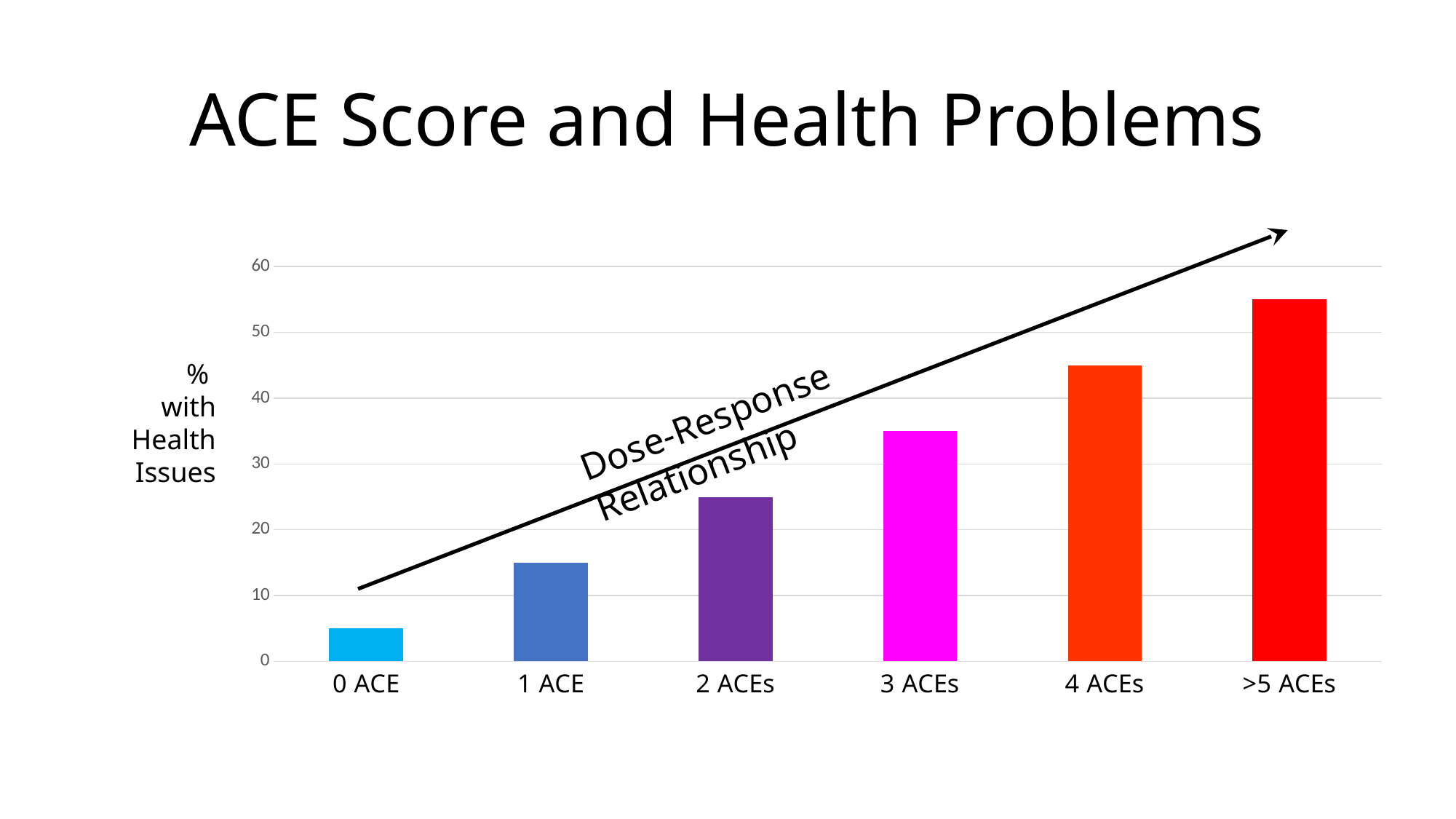
Is the value for 2 ACEs greater or less than 20? greater What relationship does the arrow annotation on the chart label? Dose-Response Relationship Is the value for 3 ACEs greater or less than 30? greater Which ACE score category has the highest percentage with health issues? >5 ACEs What type of chart is shown on the slide? bar chart Is the value for 1 ACE greater or less than 20? less Which ACE score category has the lowest percentage with health issues? 0 ACE Do the values rise or fall as the ACE score increases along the x axis? rise Which has a higher percentage with health issues, 4 ACEs or 2 ACEs? 4 ACEs How many ACE score categories are plotted on the chart? 6